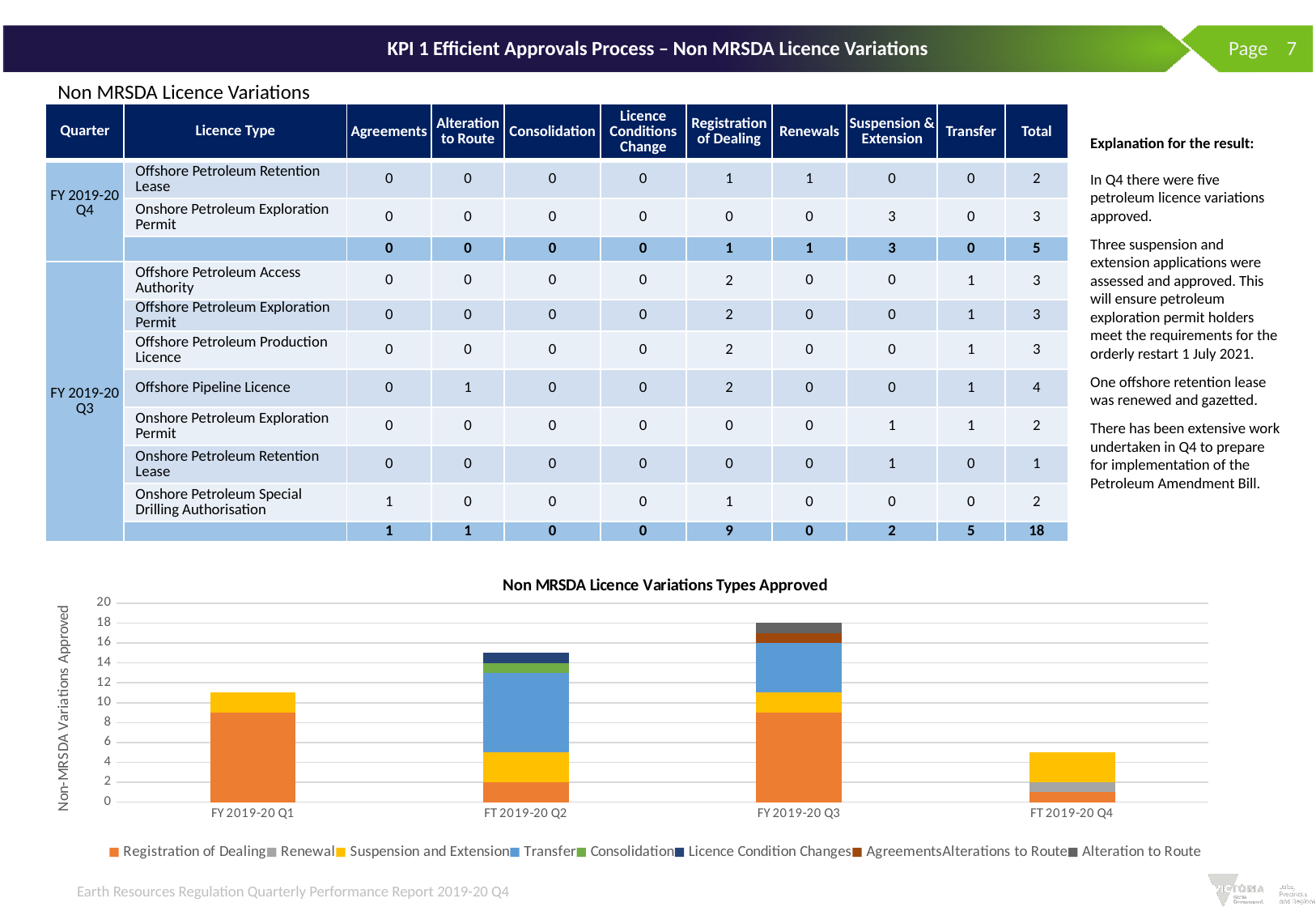
Which quarter has the tallest bar in the chart? FY 2019-20 Q3 Which bar is taller, FY 2019-20 Q1 or FT 2019-20 Q2? FT 2019-20 Q2 What is the value of the Registration of Dealing segment for FY 2019-20 Q3? 9 What is the difference between the total bar heights for FY 2019-20 Q3 and FT 2019-20 Q4? 13 How many quarters are plotted along the x axis of the chart? 4 What colour represents Transfer in the chart legend? Blue Is the total bar height for FT 2019-20 Q2 greater or less than 14? greater What is the total number of non-MRSDA variations approved for FY 2019-20 Q3 in the chart? 18 Is the total bar height for FY 2019-20 Q1 greater or less than 10? greater What is the total number of non-MRSDA variations approved for FT 2019-20 Q4 in the chart? 5 Which quarter has the shortest bar in the chart? FT 2019-20 Q4 What kind of chart is shown under the title 'Non MRSDA Licence Variations Types Approved'? Stacked bar chart